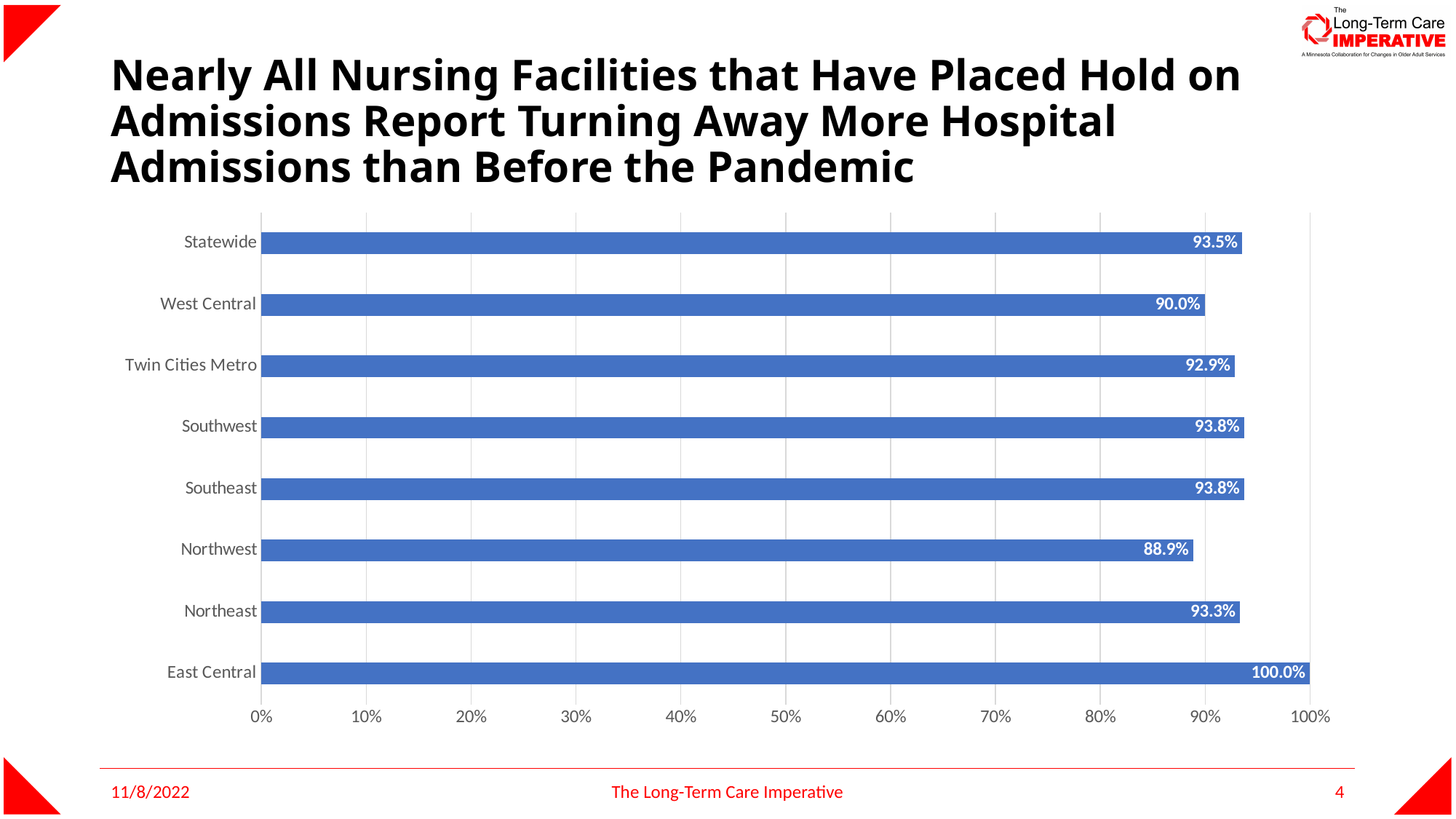
What is the value for Twin Cities Metro? 92.9% What is the Statewide value? 93.5% What is the difference between the Statewide value and the West Central value? 3.5% Which is larger, the value for West Central or the value for Northeast? Northeast How many categories are shown on the chart? 8 What is the difference between the East Central value and the Northwest value? 11.1% What is the value for Northwest? 88.9% Which category has the lowest value? Northwest What kind of chart is shown on the slide? bar chart Is the value for Northwest greater or less than 90%? less What is the value for East Central? 100.0% Which category has the highest value? East Central